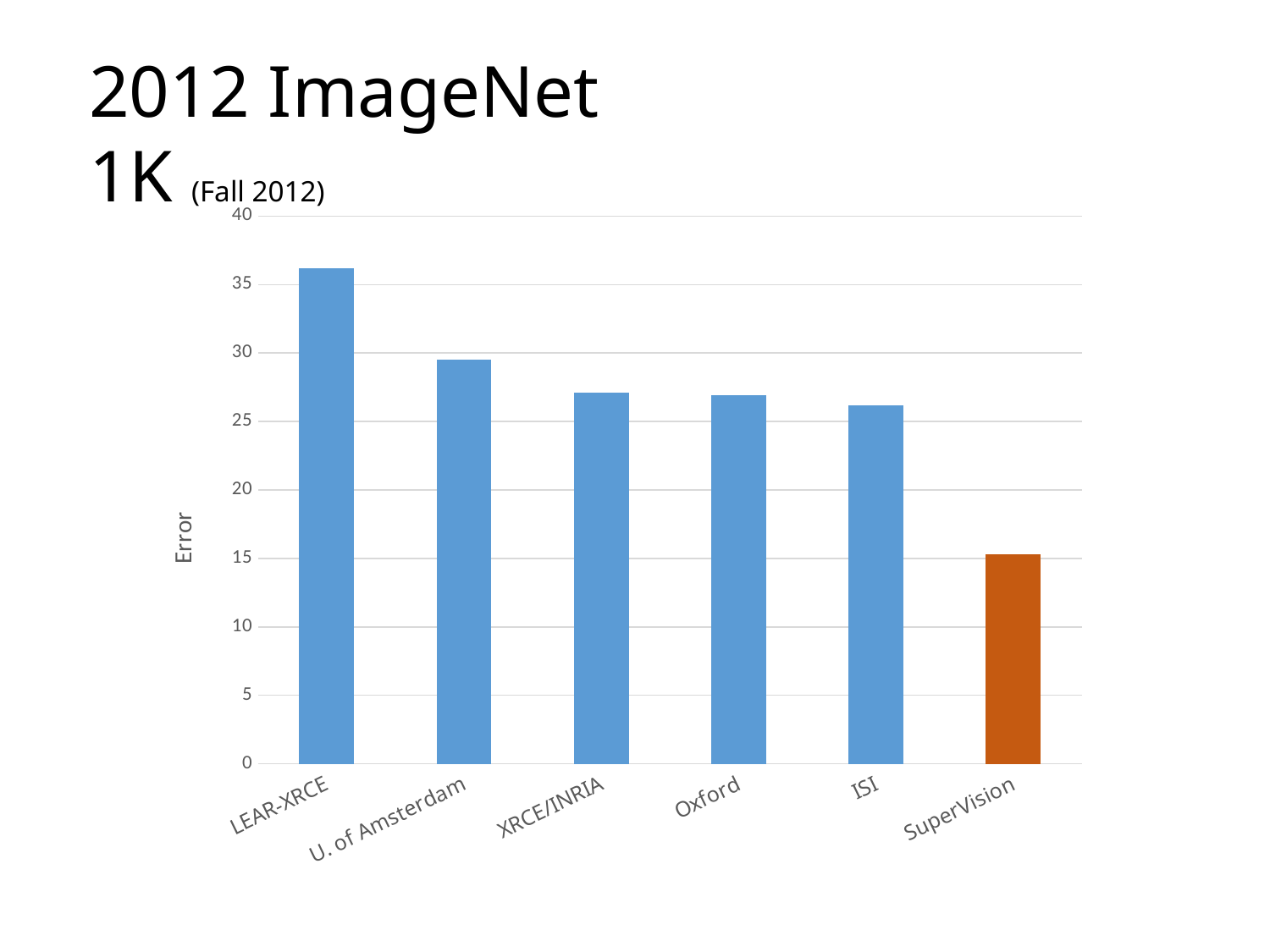
Is the error for LEAR-XRCE greater or less than 35? greater Do the error values rise or fall moving from left to right across the chart? fall Is the error for Oxford greater or less than 30? less Is the error for ISI greater or less than 25? greater Which team has the lowest error on the chart? SuperVision What kind of chart is shown on the slide? bar chart How many teams (categories) are plotted on the chart? 6 Which team has the highest error on the chart? LEAR-XRCE Which has the larger error, ISI or SuperVision? ISI Which has the larger error, LEAR-XRCE or U. of Amsterdam? LEAR-XRCE What is the label on the vertical axis of the chart? Error